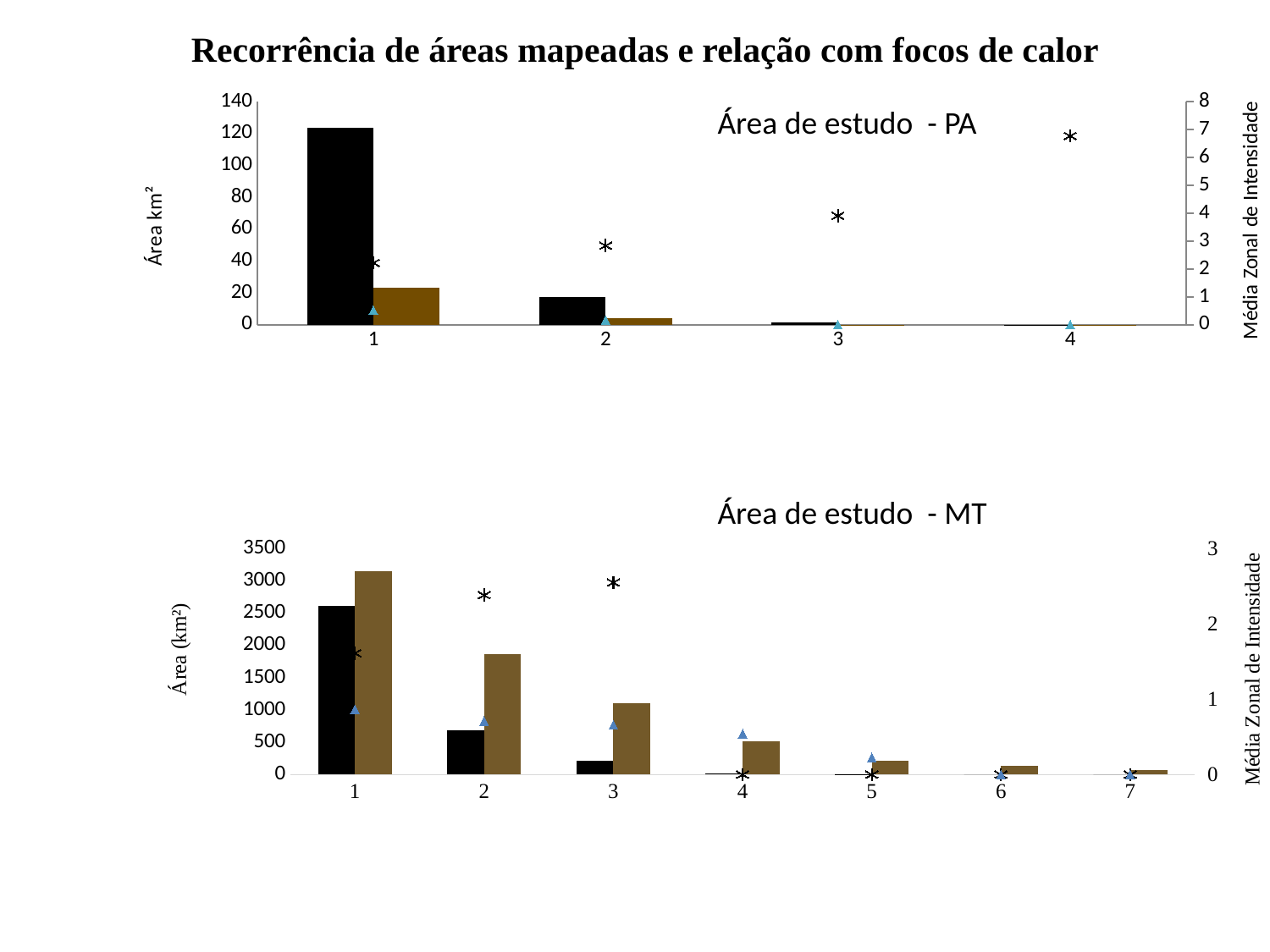
In the 'Área de estudo - PA' chart, how many categories are shown on the x axis? 4 In the 'Área de estudo - MT' chart, is the black bar for category 1 greater or less than 3000? less In the 'Área de estudo - MT' chart, do the brown bars rise or fall from category 1 to category 7? fall In the 'Área de estudo - PA' chart, do the asterisk markers rise or fall from category 1 to category 4? rise In the 'Área de estudo - PA' chart, is the brown bar for category 1 greater or less than 40? less In the 'Área de estudo - MT' chart, how many categories are shown on the x axis? 7 In the 'Área de estudo - MT' chart, is the brown bar for category 1 greater or less than 3000? greater In the 'Área de estudo - MT' chart, which bar is taller for category 1, the black bar or the brown bar? the brown bar What kind of chart is the 'Área de estudo - PA' chart? combination bar and line chart In the 'Área de estudo - PA' chart, which category has the tallest black bar? 1 What is the title of the right-hand vertical axis of the 'Área de estudo - MT' chart? Média Zonal de Intensidade